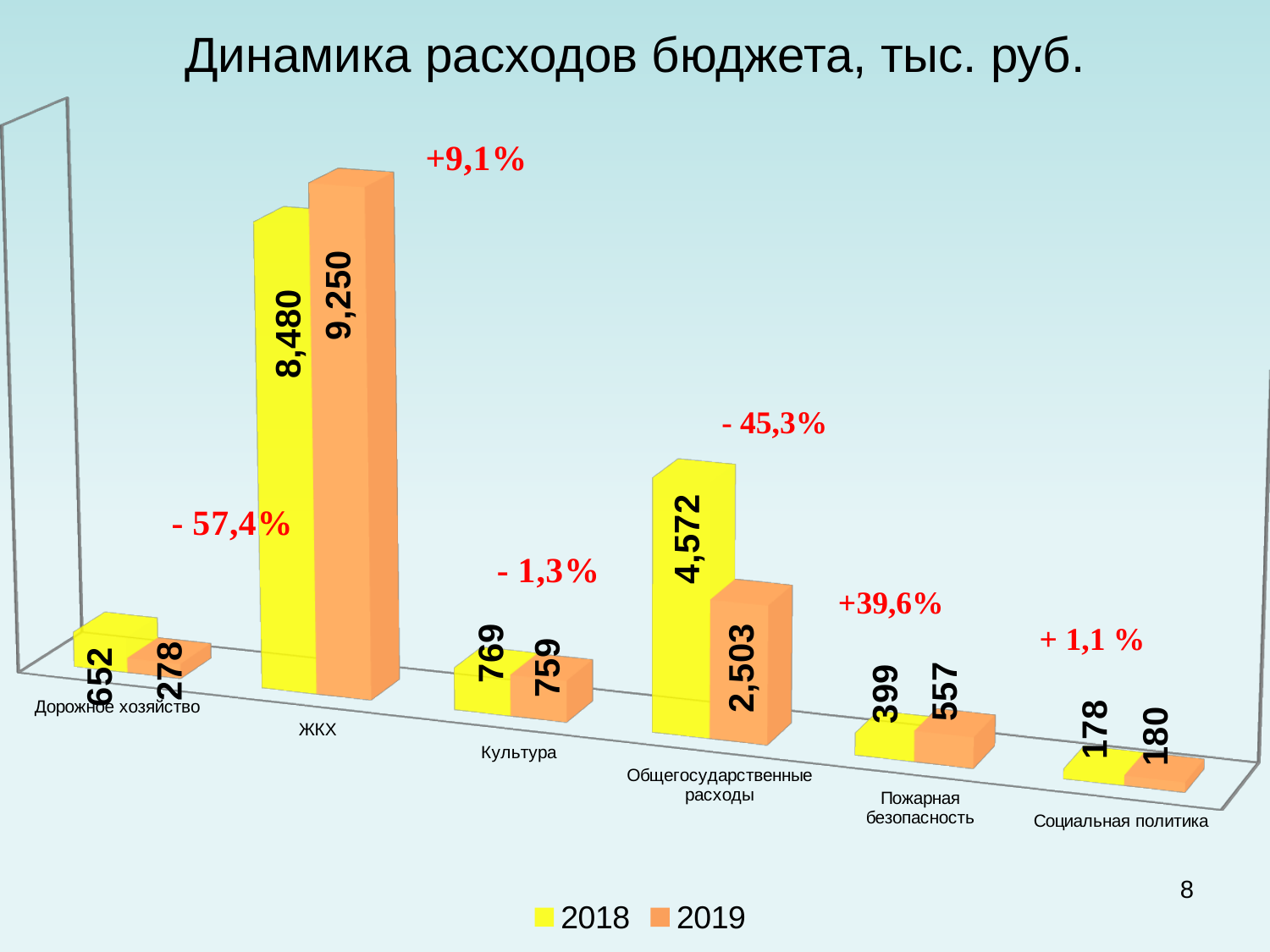
Which category has the highest value in 2018? ЖКХ What kind of chart is shown on the slide? Bar chart Which is larger for Общегосударственные расходы: the 2018 value or the 2019 value? 2018 What is the value for Пожарная безопасность in 2019? 557 How many series does the legend list? 2 Which category has the lowest value in 2019? Социальная политика What is the difference between the 2019 and 2018 values for ЖКХ? 770 What is the value for Общегосударственные расходы in 2018? 4,572 How many categories are shown on the chart? 6 What is the value for ЖКХ in 2019? 9,250 What is the difference between the 2018 and 2019 values for Дорожное хозяйство? 374 What percentage change is annotated above the Пожарная безопасность bars? +39,6%